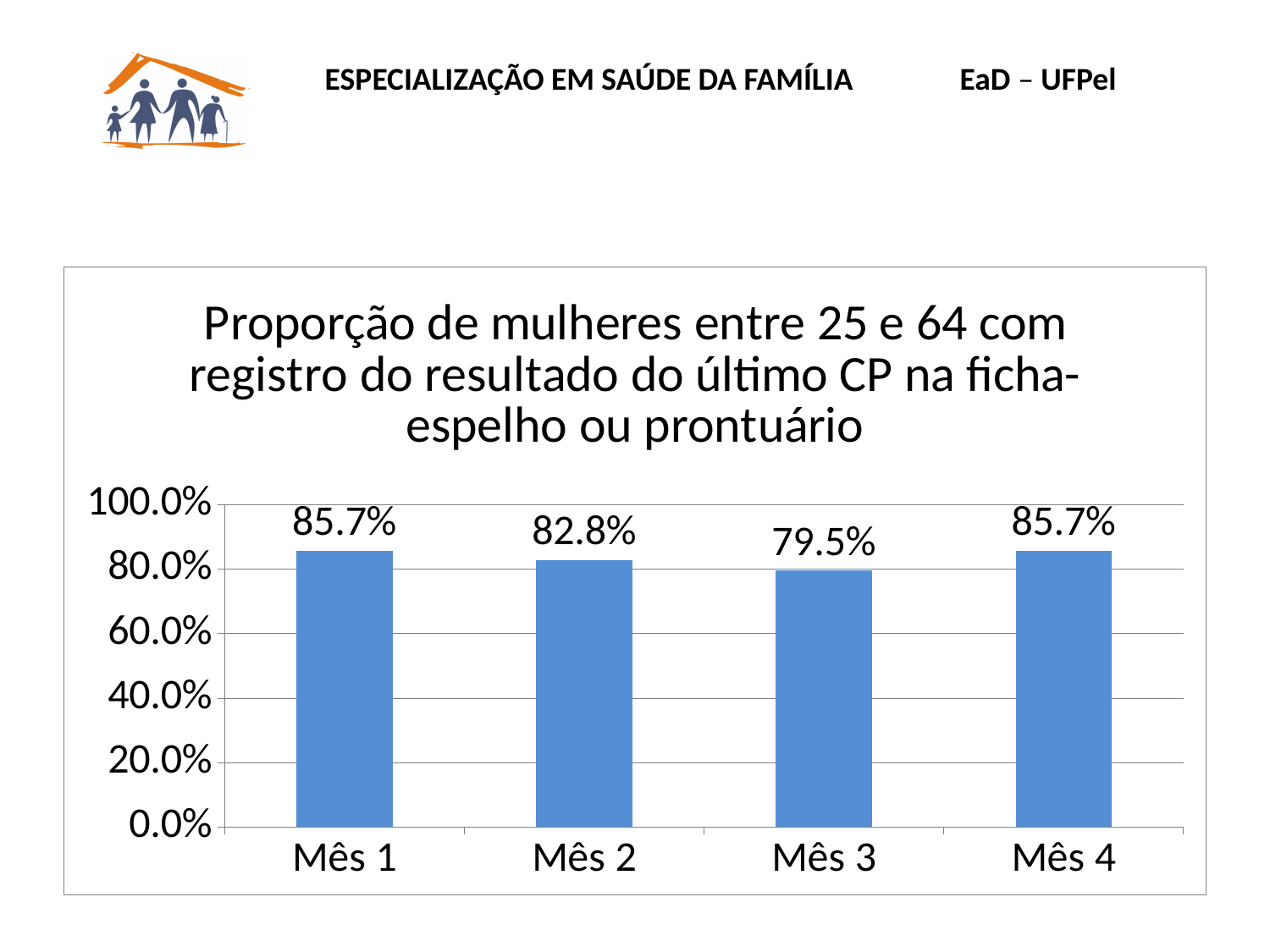
Do the values rise or fall from Mês 1 to Mês 3? fall What kind of chart is shown on the slide? bar chart What is the value for Mês 3? 79.5% What is the value for Mês 2? 82.8% What is the difference between the values for Mês 2 and Mês 3? 3.3% What is the difference between the values for Mês 1 and Mês 3? 6.2% What is the value for Mês 4? 85.7% What is the value for Mês 1? 85.7% Which is larger, the value for Mês 2 or the value for Mês 3? Mês 2 Which month has the lowest value? Mês 3 Is the value for Mês 3 greater or less than 80.0%? less How many months are shown on the x axis? 4